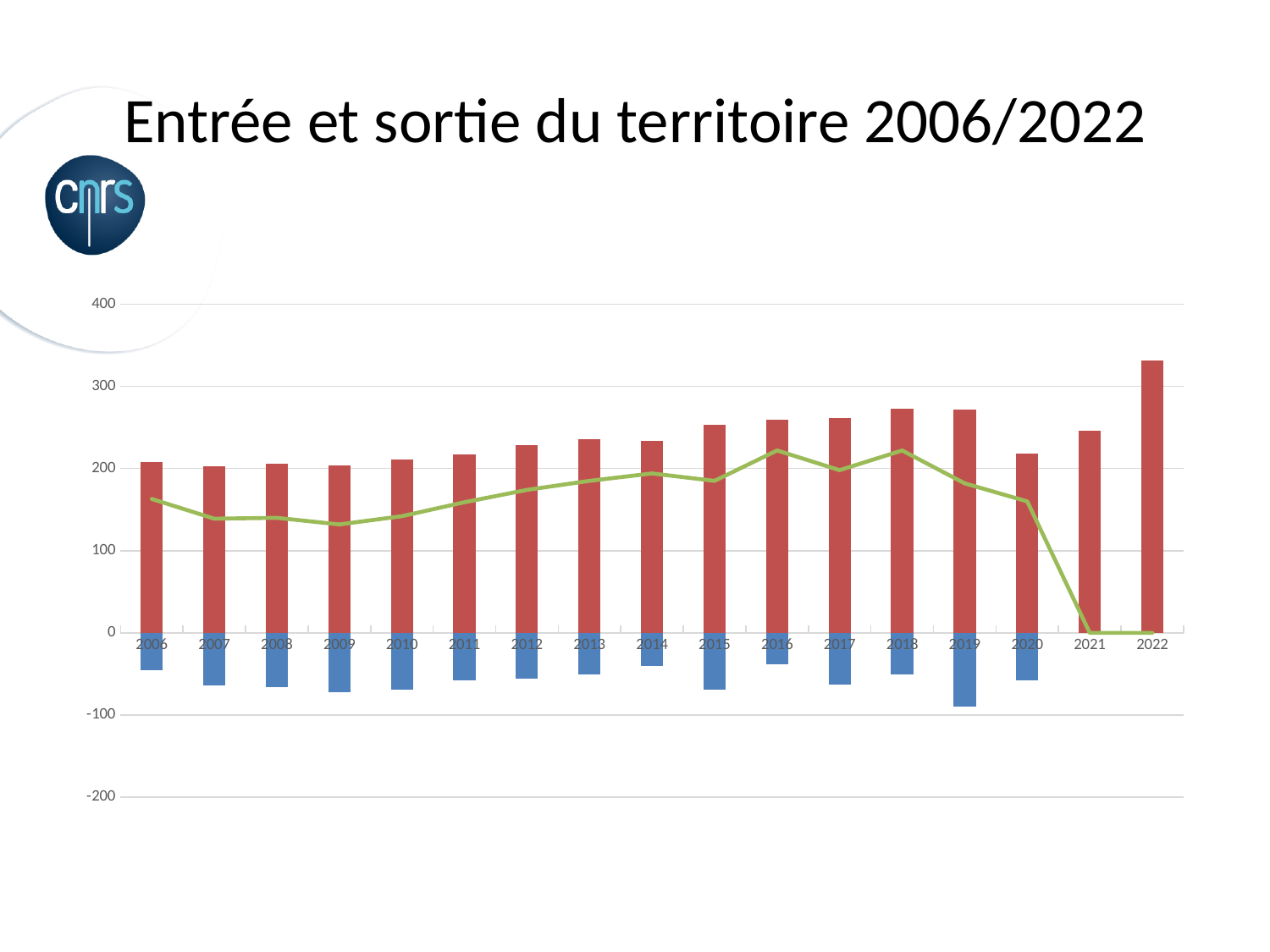
Is the green line higher in 2016 or in 2009? 2016 How many years are shown along the x axis of the chart? 17 Which red bar is taller, 2021 or 2022? 2022 Is the value of the green line for 2009 greater or less than 100? greater In which year is the red bar the highest? 2022 In which year does the blue bar extend furthest below zero? 2019 What kind of chart is shown on the slide? A combined bar and line chart Is the value of the red bar for 2018 greater or less than 300? less Is the value of the red bar for 2022 greater or less than 300? greater Does the green line rise or fall between 2020 and 2021? fall What is the title of the chart on the slide? Entrée et sortie du territoire 2006/2022 Which red bar is taller, 2010 or 2015? 2015